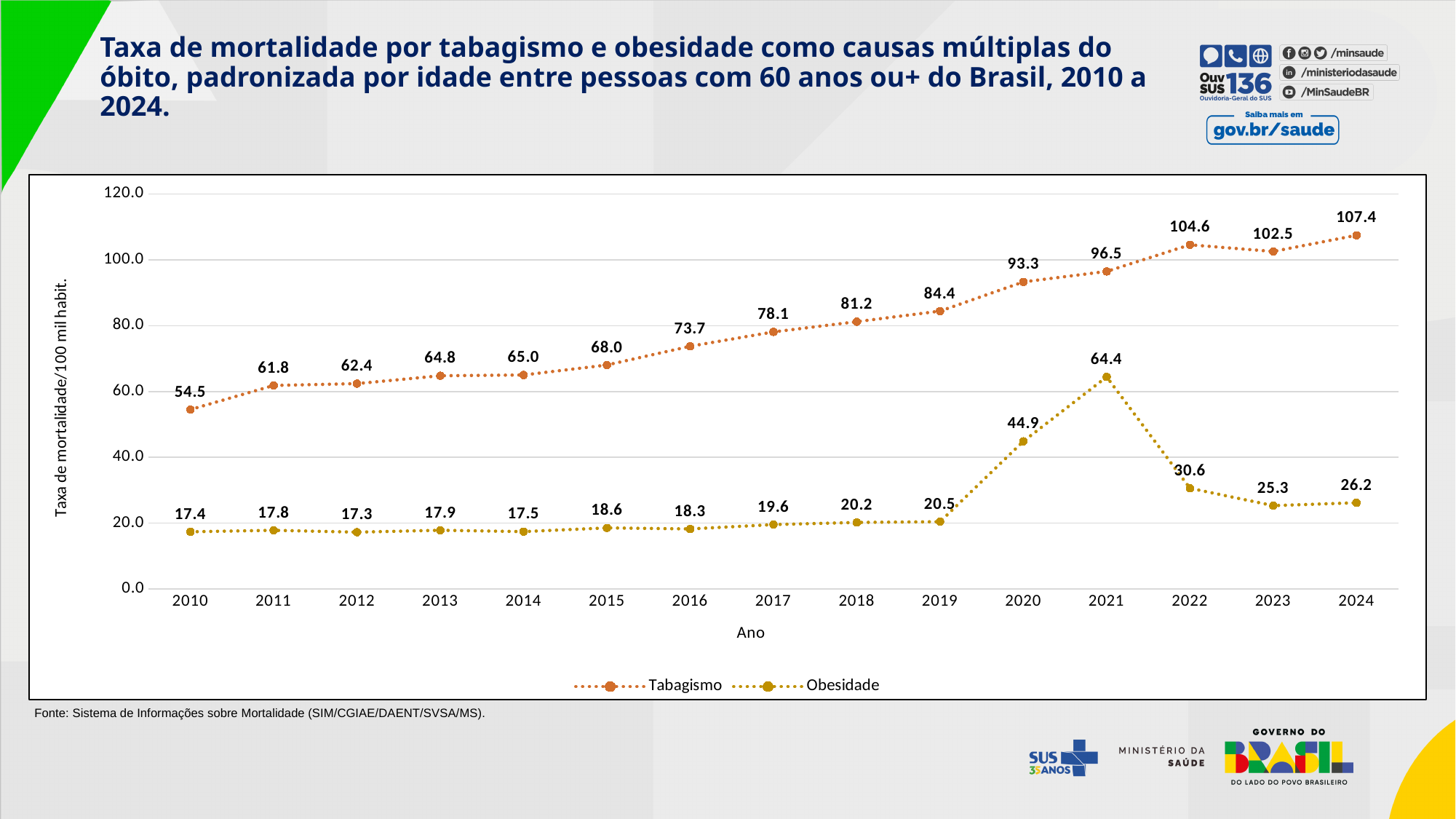
What kind of chart is shown on the slide? Line chart How many years are shown on the x axis? 15 What is the difference between the Tabagismo and Obesidade rates in 2024? 81.2 In which year is the Tabagismo rate lowest? 2010 What is the Tabagismo value for 2018? 81.2 In which year is the Tabagismo rate highest? 2024 What is the Obesidade mortality rate in 2021? 64.4 By how much did the Obesidade rate increase from 2020 to 2021? 19.5 In which year is the Obesidade rate highest? 2021 What is the Tabagismo mortality rate in 2010? 54.5 How many series does the legend list? 2 Which is larger, the Tabagismo rate in 2022 or in 2023? 2022